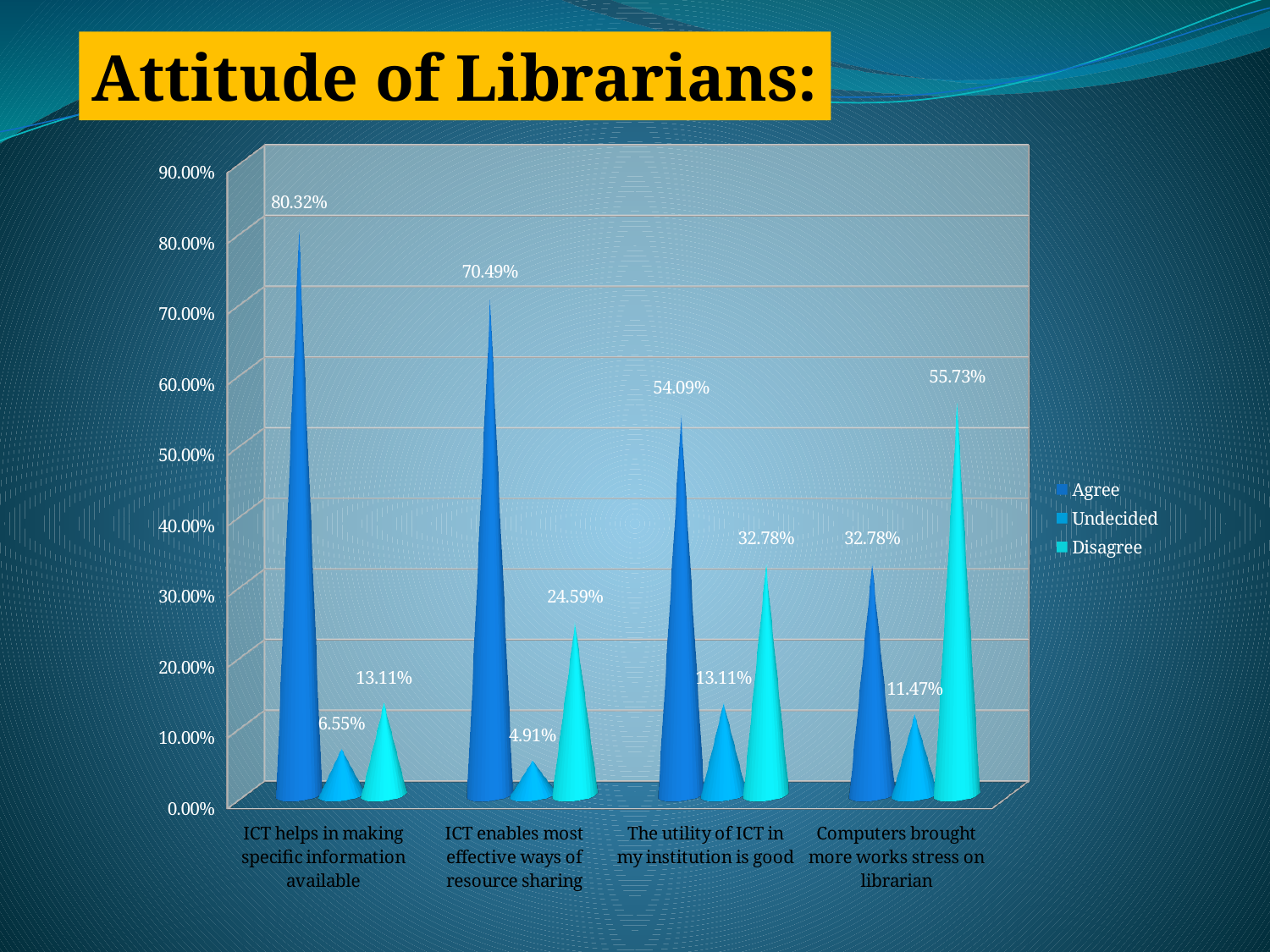
What is the Agree value for "ICT helps in making specific information available"? 80.32% How many categories are shown on the x axis? 4 What kind of chart is shown on the slide? bar chart Is the Agree value for "The utility of ICT in my institution is good" greater or less than 50.00%? greater What is the Undecided value for "ICT enables most effective ways of resource sharing"? 4.91% Which category has the lowest Undecided value? ICT enables most effective ways of resource sharing How many series does the legend list? 3 Which category has the highest Agree value? ICT helps in making specific information available What is the Disagree value for "The utility of ICT in my institution is good"? 32.78% For "Computers brought more works stress on librarian", which is larger: Agree or Disagree? Disagree What is the Disagree value for "Computers brought more works stress on librarian"? 55.73% What is the difference between the Agree and Disagree values for "ICT enables most effective ways of resource sharing"? 45.90%